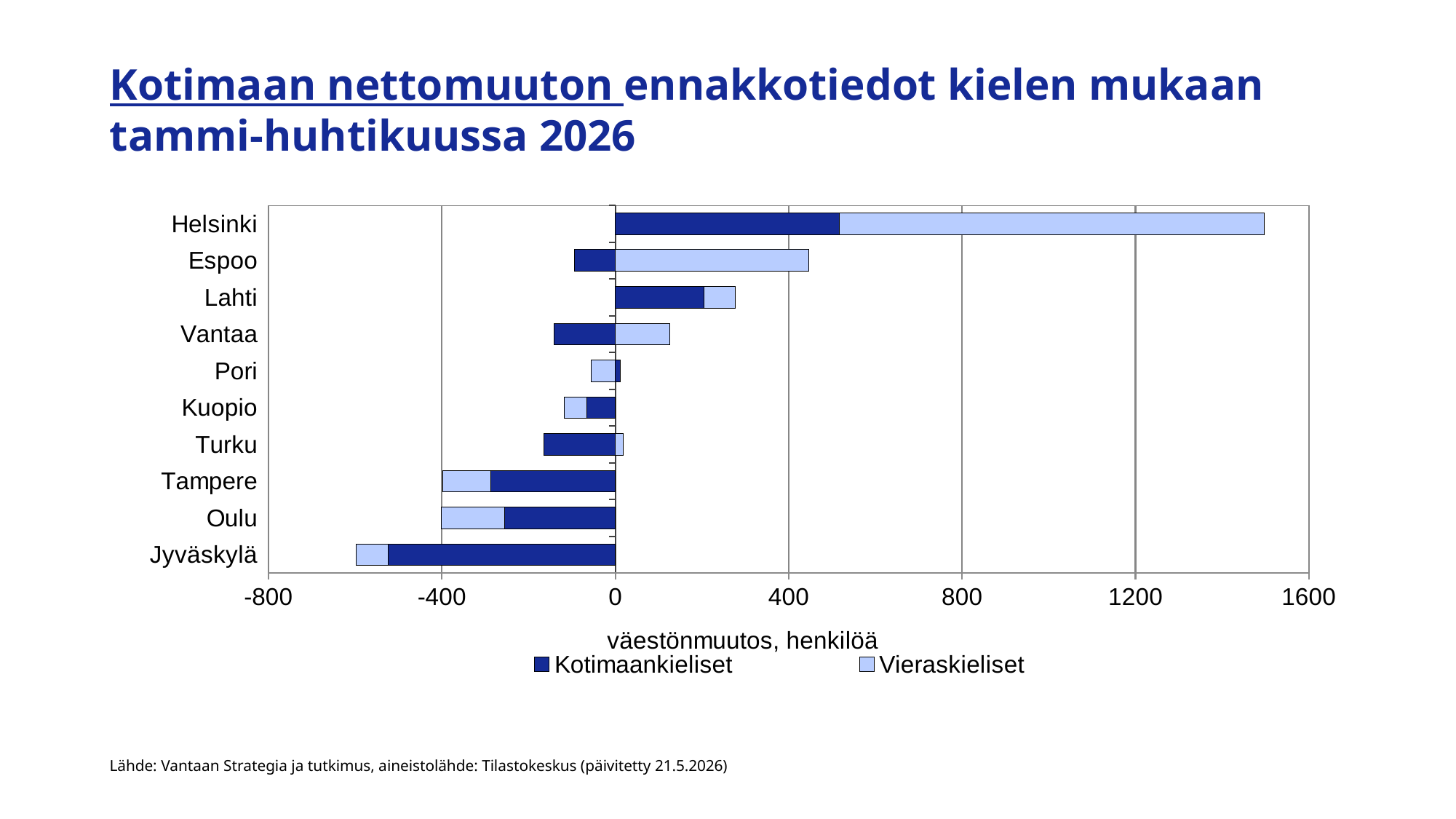
Is the Vieraskieliset value for Helsinki greater or less than 800? greater Which series is shown in dark blue in the chart legend? Kotimaankieliset How many cities are listed on the vertical axis of the chart? 10 Is the Kotimaankieliset value for Jyväskylä greater or less than -400? less What is the label of the horizontal axis of the chart? väestönmuutos, henkilöä Which city has the highest Vieraskieliset value? Helsinki Which is larger, the Vieraskieliset value for Espoo or for Vantaa? Espoo What kind of chart is shown on the slide? Stacked bar chart How many series does the chart legend list? 2 Which city has the lowest Kotimaankieliset value? Jyväskylä Is the Kotimaankieliset value for Tampere greater or less than -400? greater